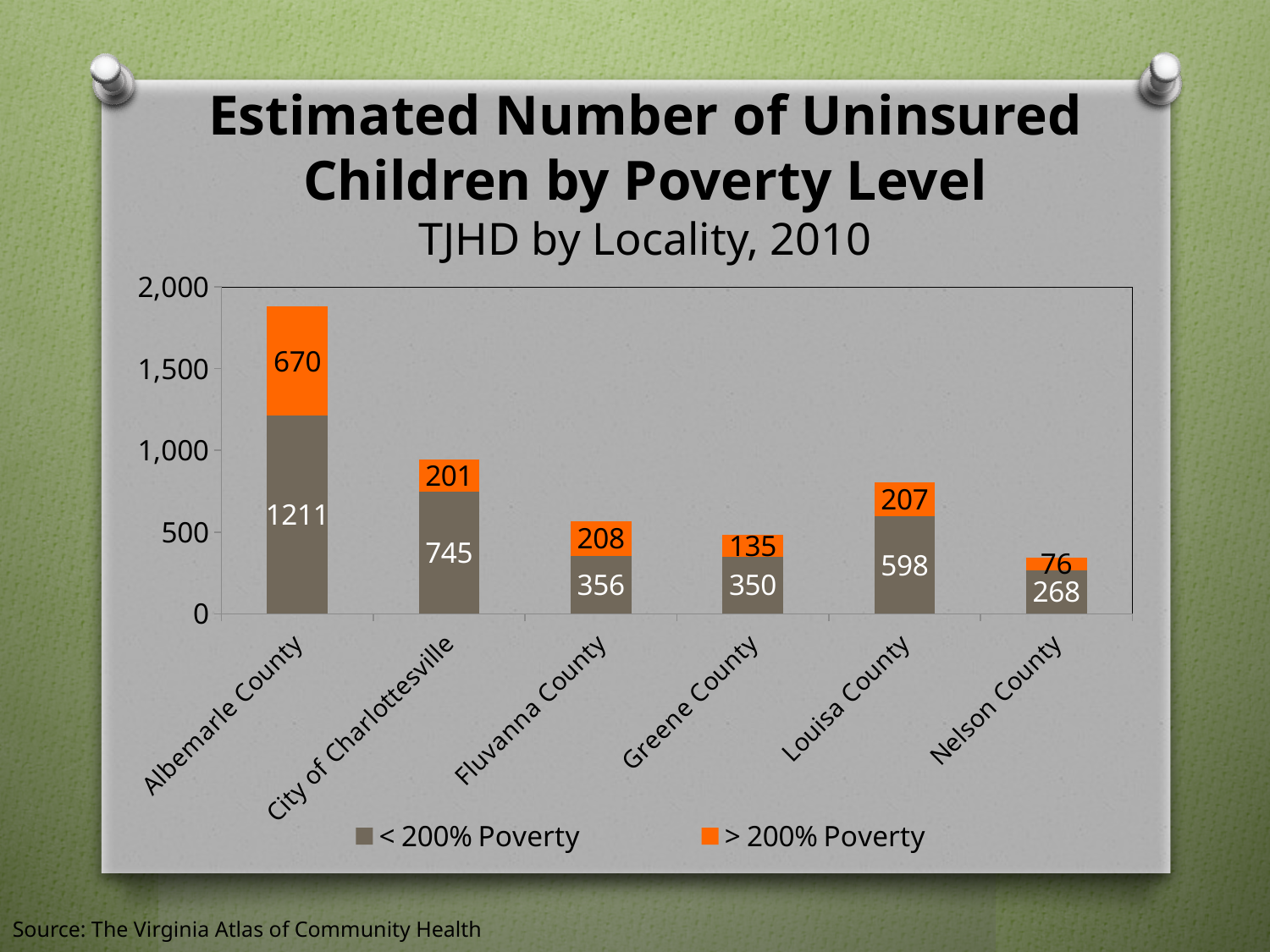
Which locality has the lowest value for < 200% Poverty? Nelson County Which is larger: the > 200% Poverty value for Fluvanna County or for Louisa County? Fluvanna County Which locality has the highest value for > 200% Poverty? Albemarle County What is the value for > 200% Poverty in Nelson County? 76 What is the total of the stacked bar for Greene County? 485 What is the value for < 200% Poverty in Louisa County? 598 What is the difference between the < 200% Poverty values for City of Charlottesville and Louisa County? 147 What kind of chart is shown on the slide? Stacked bar chart What is the total of the stacked bar for Albemarle County? 1881 What is the value for < 200% Poverty in Albemarle County? 1211 How many localities are shown on the x axis? 6 How many series does the legend list? 2